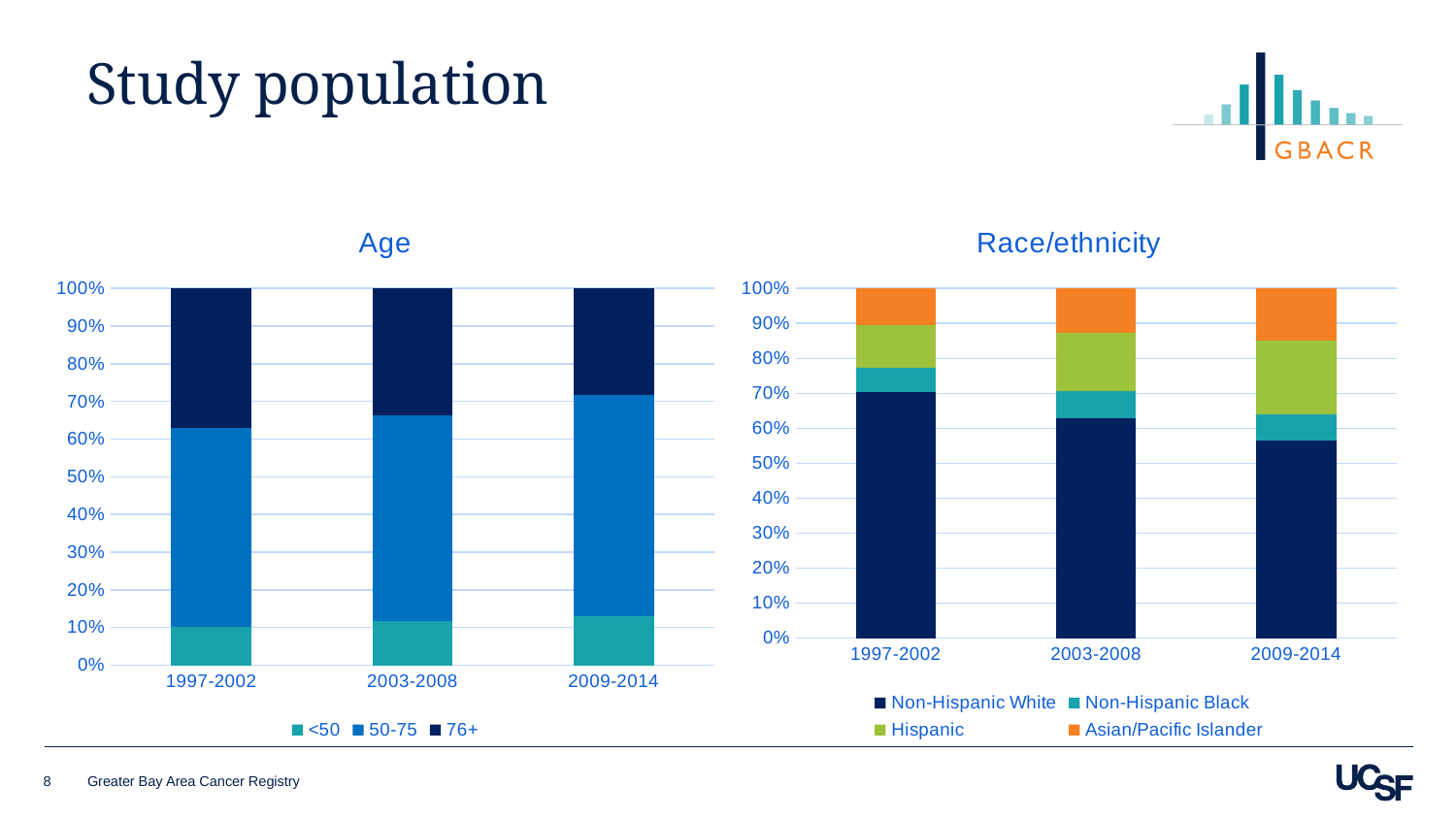
In the Race/ethnicity chart, does the Hispanic share rise or fall from 1997-2002 to 2009-2014? rise In the Race/ethnicity chart, does the Non-Hispanic White share rise or fall from 1997-2002 to 2009-2014? fall Which series in the Race/ethnicity chart is shown in orange? Asian/Pacific Islander In the Race/ethnicity chart, is the Non-Hispanic White share for 2009-2014 greater or less than 60%? less How many series does the legend of the Race/ethnicity chart list? 4 In the Race/ethnicity chart, is the Non-Hispanic White share for 1997-2002 greater or less than 60%? greater In the Age chart, is the combined share of the <50 and 50-75 groups for 1997-2002 greater or less than 60%? greater How many time periods are shown on the x axis of the Race/ethnicity chart? 3 What is the title of the chart on the right side of the slide? Race/ethnicity In the Age chart, does the 76+ share rise or fall from 1997-2002 to 2009-2014? fall How many series does the legend of the Age chart list? 3 What kind of chart is the Age chart? stacked bar chart